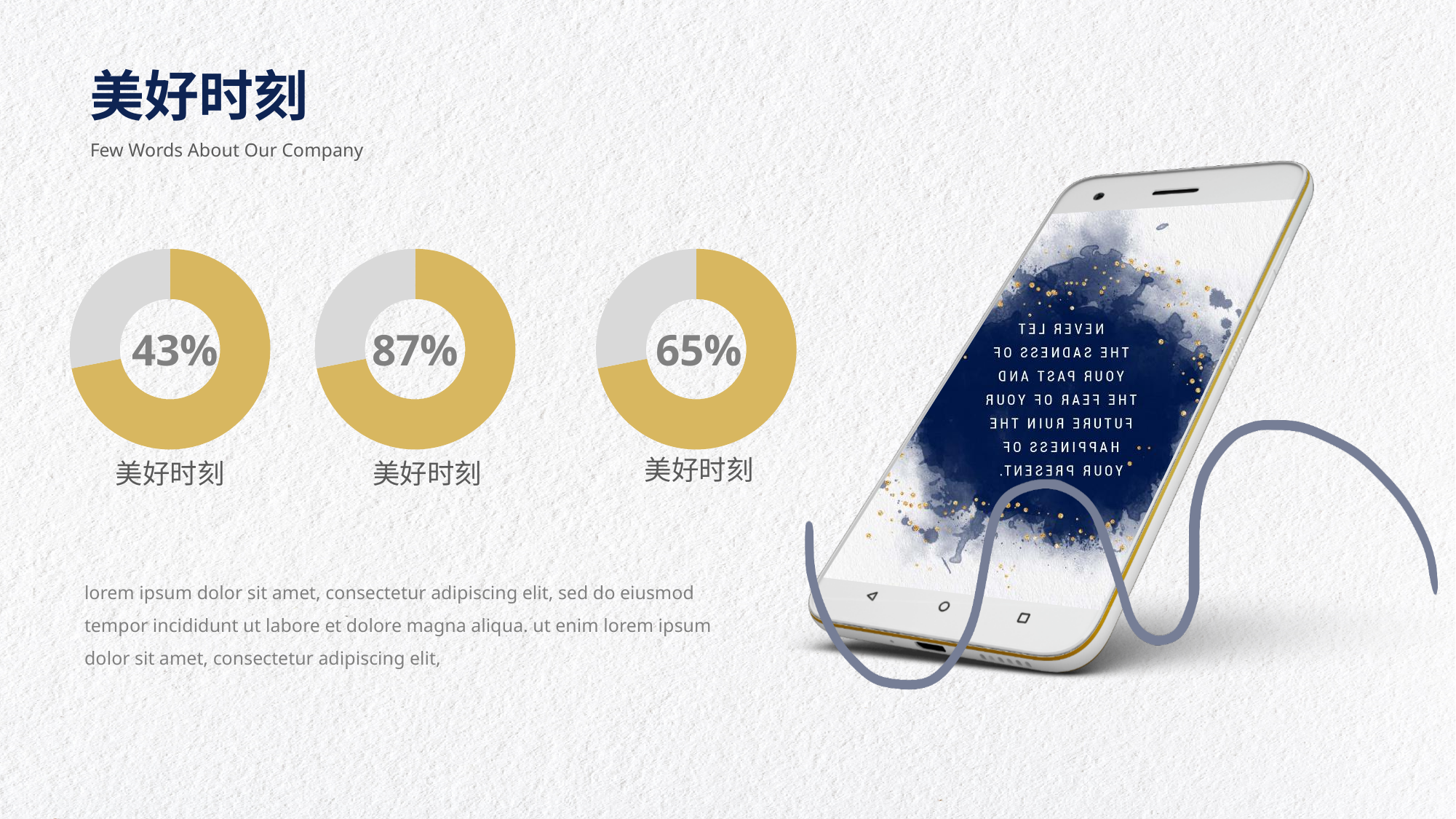
What value is shown in the centre of the left donut chart? 43% What kind of chart is used to display the three percentages on the slide? donut chart What label appears beneath each of the three donut charts? 美好时刻 What value is shown in the centre of the middle donut chart? 87% What value is shown in the centre of the right donut chart? 65% Is the percentage in the right donut chart larger or smaller than the percentage in the left donut chart? larger Which of the three donut charts shows the highest percentage: left, middle or right? middle What is the difference between the percentage in the middle donut chart and the percentage in the left donut chart? 44% How many donut charts are shown on the slide? 3 What colour is the filled portion of the donut charts? gold Which of the three donut charts shows the lowest percentage: left, middle or right? left What is the difference between the percentage in the middle donut chart and the percentage in the right donut chart? 22%